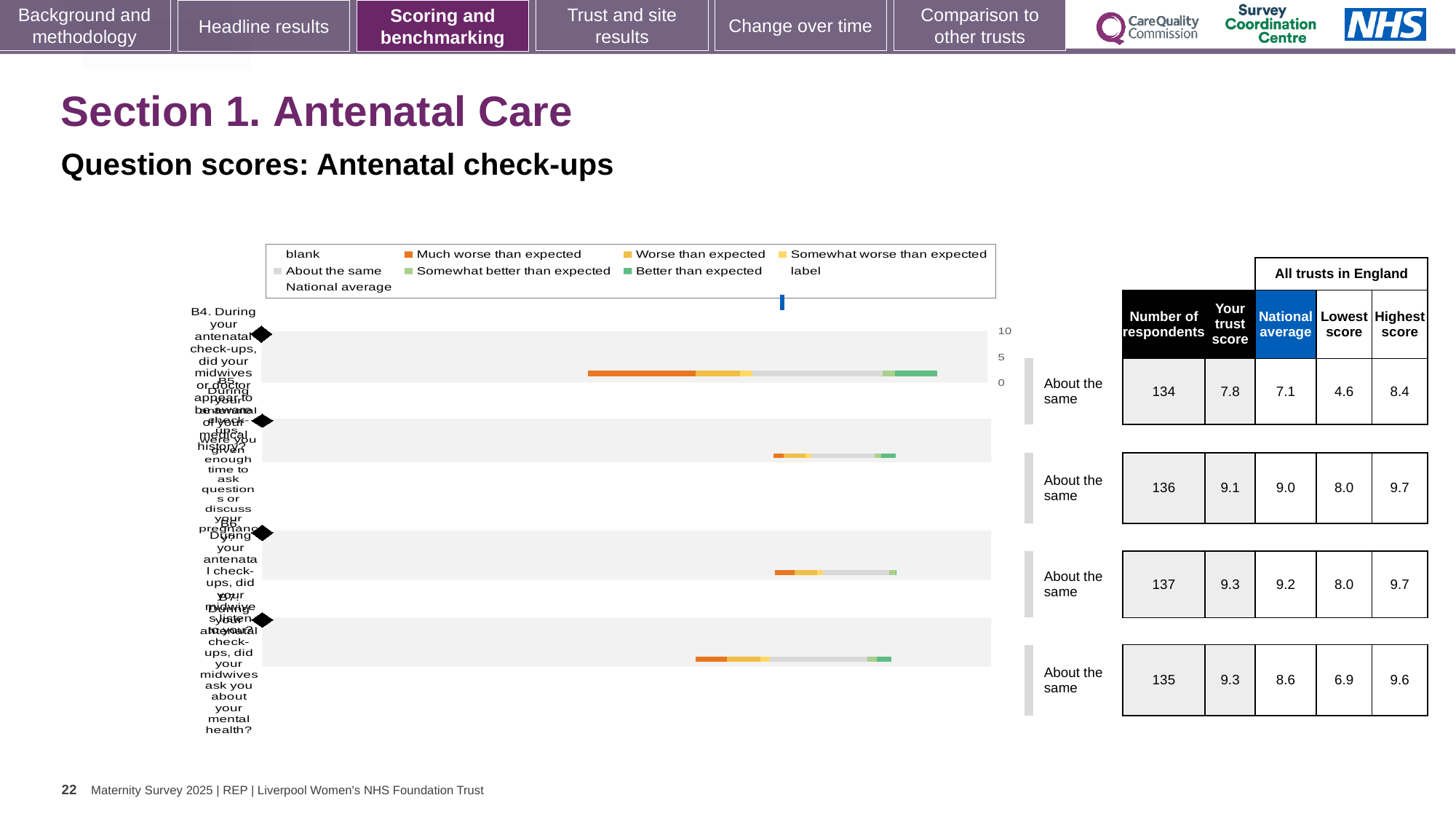
What is the national average for question B7? 8.6 What colour represents 'Much worse than expected' in the chart legend? Orange What is the difference between the trust score and the national average for question B7? 0.7 For question B5, which is larger: the trust score or the national average? Trust score How many entries does the chart legend list? 9 What is the 'Your trust score' for question B4? 7.8 What benchmark category is shown for question B4? About the same Which question has the lowest 'Your trust score'? B4 How many respondents answered question B6? 137 What kind of chart is shown on the slide? Bar chart How many questions (bars) are plotted in the chart? 4 What is the highest score among all trusts in England for question B5? 9.7